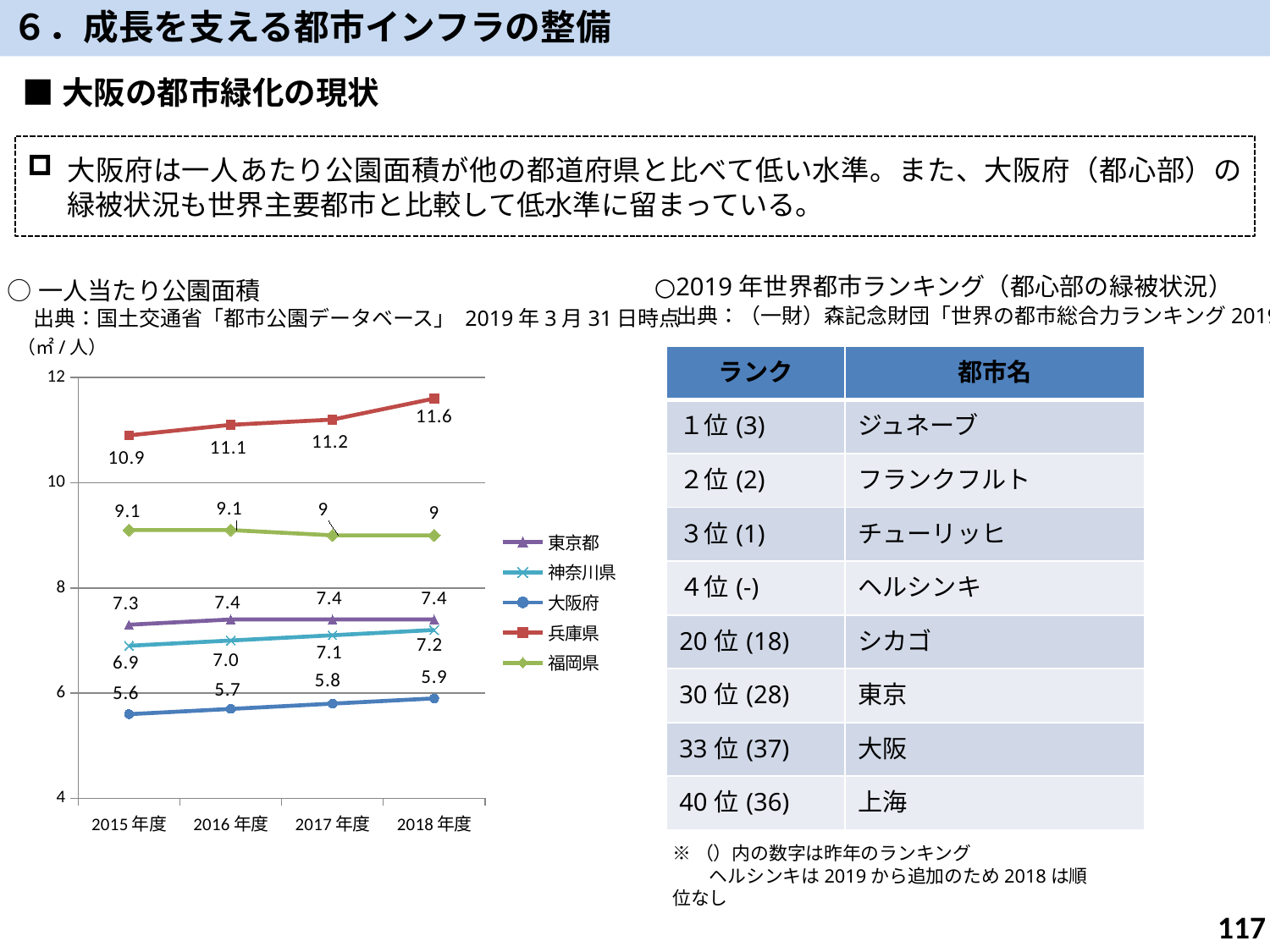
What unit is shown above the y axis of the 一人当たり公園面積 chart? ㎡/人 Which prefecture has the lowest value in 2015年度 in the 一人当たり公園面積 chart? 大阪府 How many fiscal years are shown on the x axis of the 一人当たり公園面積 chart? 4 What is the value for 兵庫県 in 2015年度 in the 一人当たり公園面積 chart? 10.9 What type of chart is the 一人当たり公園面積 chart? line chart What is the value for 大阪府 in 2018年度 in the 一人当たり公園面積 chart? 5.9 What is the difference between 兵庫県 and 大阪府 in 2018年度 in the 一人当たり公園面積 chart? 5.7 In the 一人当たり公園面積 chart, which is larger in 2016年度: 東京都 or 神奈川県? 東京都 What is the value for 神奈川県 in 2017年度 in the 一人当たり公園面積 chart? 7.1 Does the value for 兵庫県 rise or fall from 2015年度 to 2018年度 in the 一人当たり公園面積 chart? rise Which prefecture has the highest value in 2018年度 in the 一人当たり公園面積 chart? 兵庫県 How many series does the legend of the 一人当たり公園面積 chart list? 5